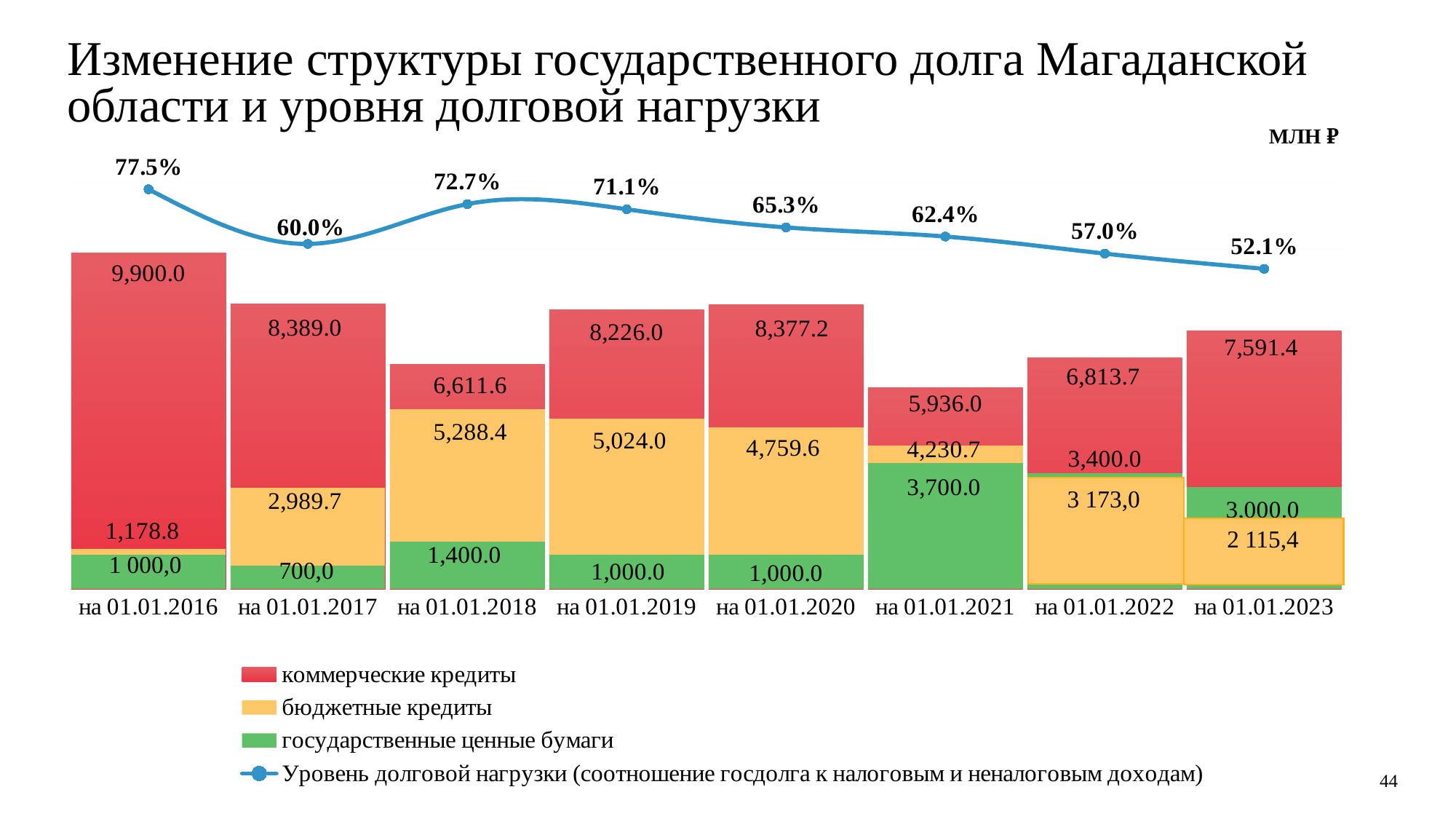
Does the Уровень долговой нагрузки overall rise or fall from 01.01.2016 to 01.01.2023? fall How many series does the legend list? 4 What is the value of государственные ценные бумаги на 01.01.2021? 3,700.0 What is the Уровень долговой нагрузки на 01.01.2020? 65.3% What kind of chart is shown on the slide? stacked bar chart with a line What is the value of коммерческие кредиты на 01.01.2016? 9,900.0 On which date is the Уровень долговой нагрузки highest? на 01.01.2016 What is the value of бюджетные кредиты на 01.01.2018? 5,288.4 On which date is the Уровень долговой нагрузки lowest? на 01.01.2023 Which is larger: бюджетные кредиты на 01.01.2018 or на 01.01.2019? на 01.01.2018 How many dates are shown on the x axis? 8 What is the difference between коммерческие кредиты на 01.01.2016 and на 01.01.2017? 1,511.0